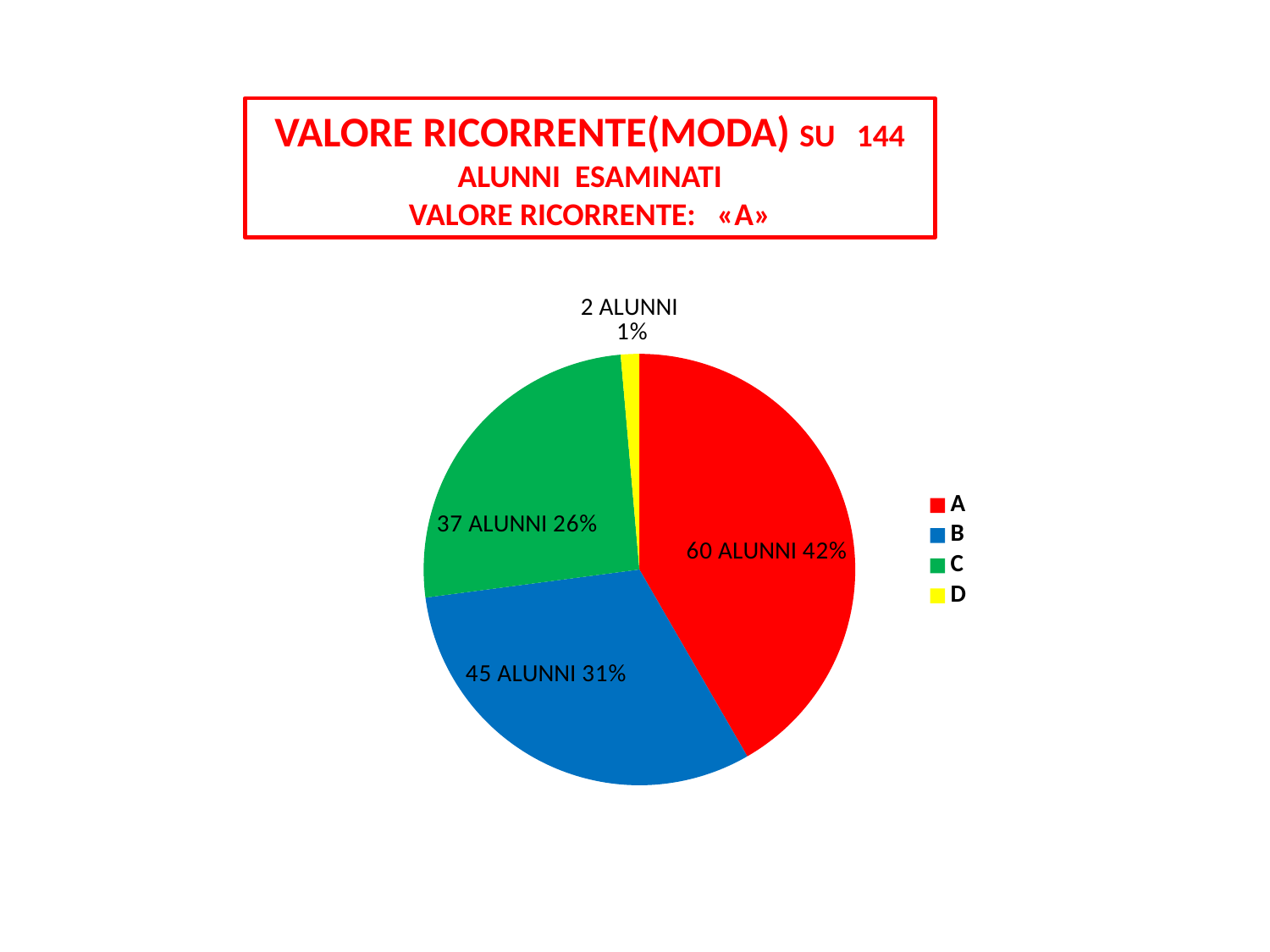
What colour is the slice for category C? green Which category has the largest slice? A Which category has the smallest slice? D How many slices does the pie chart have? 4 What kind of chart is shown on the slide? pie chart What is the difference in number of alunni between category A and category B? 15 What percentage of the pie does category D represent? 1% What percentage of the pie does category B represent? 31% How many entries does the legend list? 4 How many alunni are in category C? 37 ALUNNI How many alunni are in category A? 60 ALUNNI Which category has more alunni, B or C? B